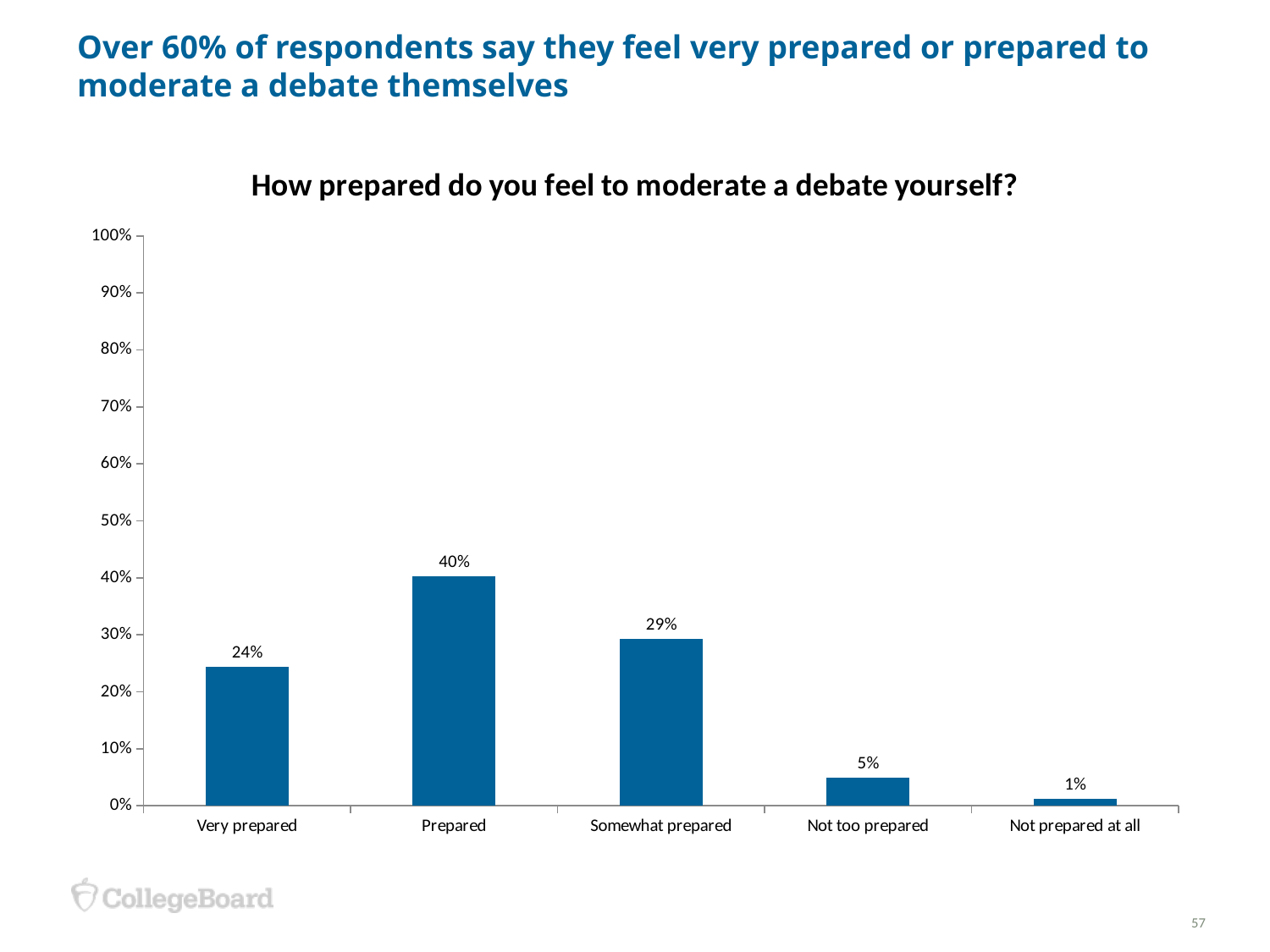
Which is larger, the value for 'Somewhat prepared' or the value for 'Very prepared'? Somewhat prepared What is the difference between the 'Prepared' and 'Very prepared' values? 16% How many categories are shown on the x axis? 5 Which category has the highest value? Prepared What kind of chart is shown on the slide? Bar chart What percentage of respondents said they are not prepared at all? 1% What is the title of the chart? How prepared do you feel to moderate a debate yourself? What is the value for the 'Prepared' category? 40% What percentage of respondents said they feel very prepared to moderate a debate? 24% Which category has the lowest value? Not prepared at all What percentage of respondents said they feel somewhat prepared? 29% What is the value for 'Not too prepared'? 5%